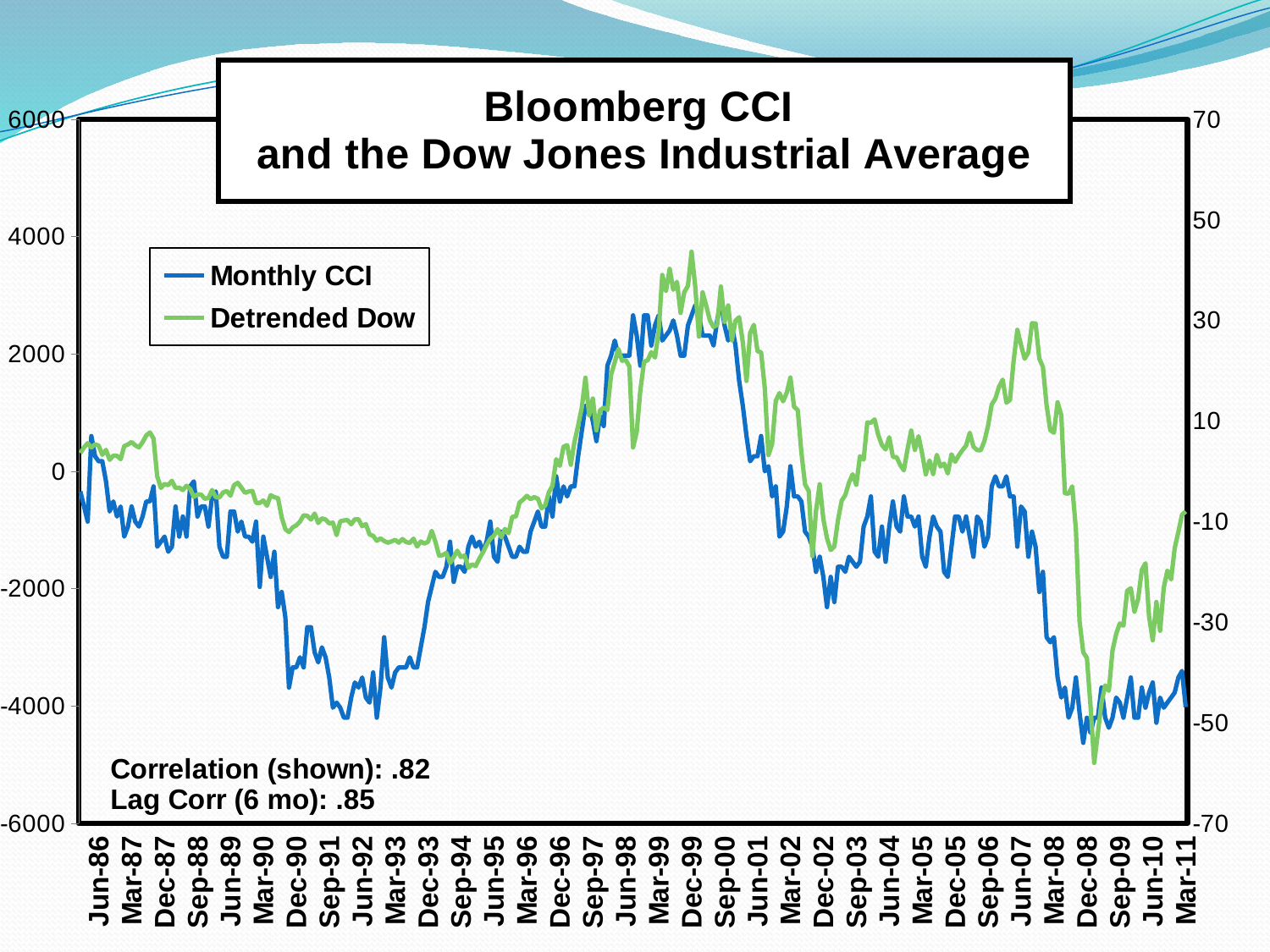
On the left-hand axis, is the Monthly CCI value around Sep-91 greater or less than -2000? less What correlation value is shown on the chart? .82 Around Jun-07, which series is higher, Monthly CCI or Detrended Dow? Detrended Dow From Dec-99 to Dec-02, does the Monthly CCI line rise or fall? Fall What colour is the Monthly CCI line? Blue What is the 6-month lag correlation shown on the chart? .85 How many series does the legend list? 2 What is the title of the chart? Bloomberg CCI and the Dow Jones Industrial Average What kind of chart is shown on the slide? Line chart How many date labels are shown along the x axis? 34 From Dec-08 to Mar-11, does the Detrended Dow line rise or fall? Rise